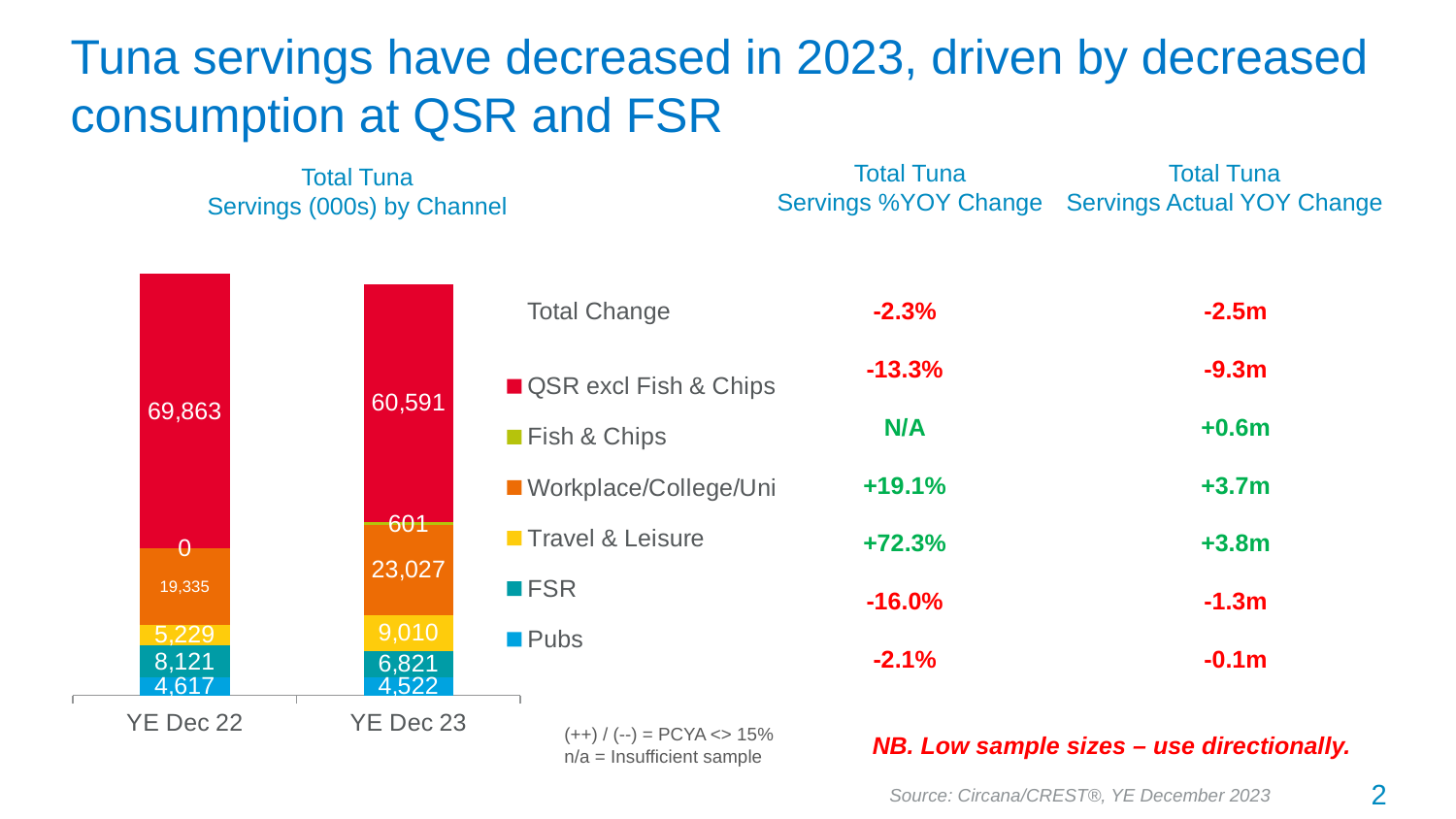
What type of chart is shown on the slide? Stacked bar chart What is the difference between the FSR values for YE Dec 22 and YE Dec 23? 1,300 How many bars (time periods) are plotted in the chart? 2 Which channel has the largest segment in the YE Dec 23 bar? QSR excl Fish & Chips What is the value for Workplace/College/Uni in YE Dec 23? 23,027 What is the value for Fish & Chips in YE Dec 22? 0 What is the value for QSR excl Fish & Chips in YE Dec 22? 69,863 Which is larger: Pubs in YE Dec 22 or Pubs in YE Dec 23? Pubs in YE Dec 22 What is the total of the YE Dec 23 stacked bar? 104,572 How many series does the chart legend list? 6 Which channel has the smallest non-zero segment in the YE Dec 23 bar? Fish & Chips What is the value for Travel & Leisure in YE Dec 23? 9,010